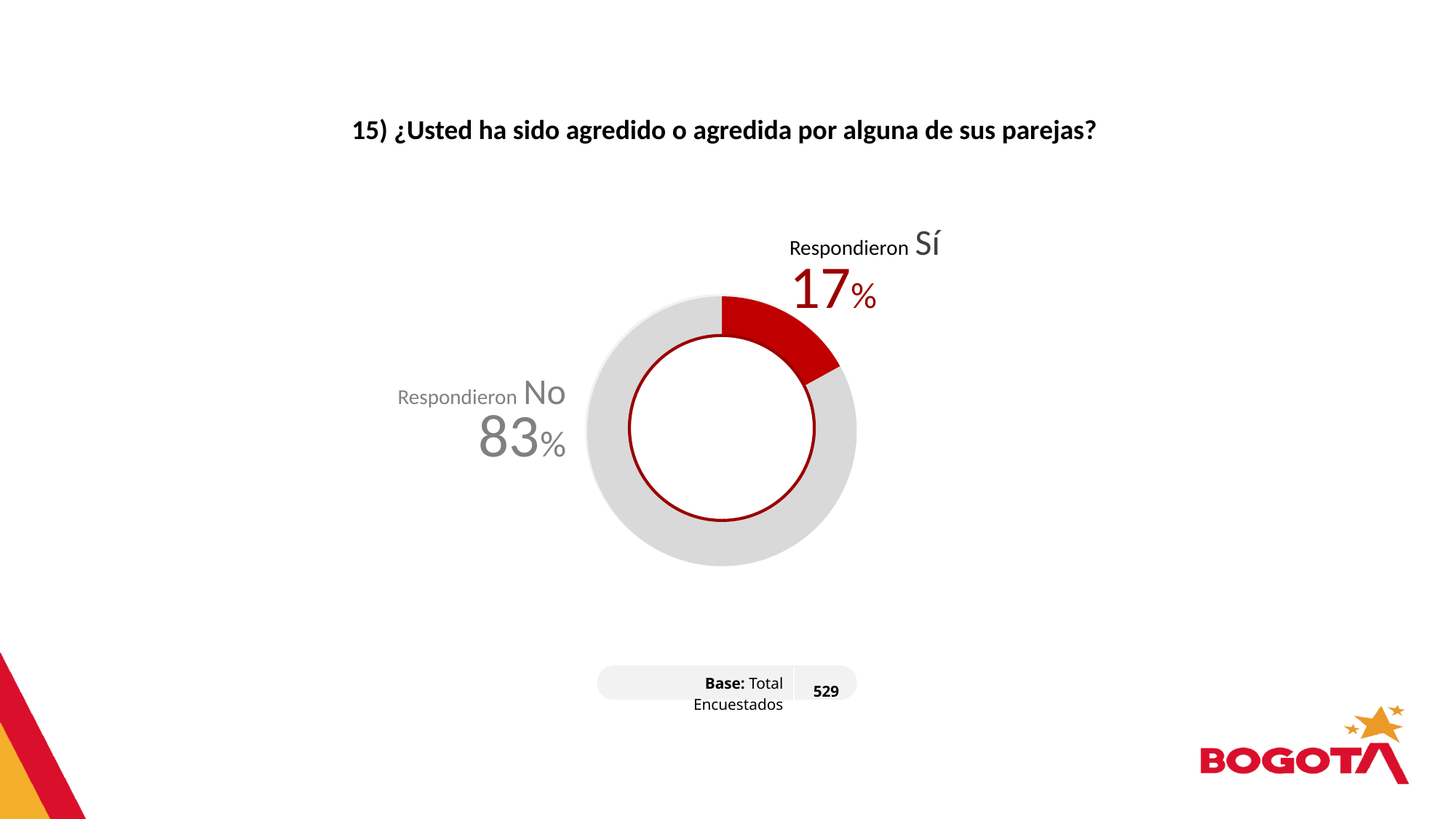
What is the base (total number of respondents) shown below the chart? 529 What percentage of respondents answered "No"? 83% Which response has the smallest share of the chart? Sí What is the total of the two percentages shown in the chart? 100% What kind of chart is shown on the slide? Doughnut chart What percentage of respondents answered "Sí"? 17% Which response has the largest share of the chart? No How many response categories are shown in the chart? 2 Which response has the larger share, "Sí" or "No"? No What is the difference in percentage points between the "No" and "Sí" responses? 66 What colour is the segment representing "Sí" responses? Red